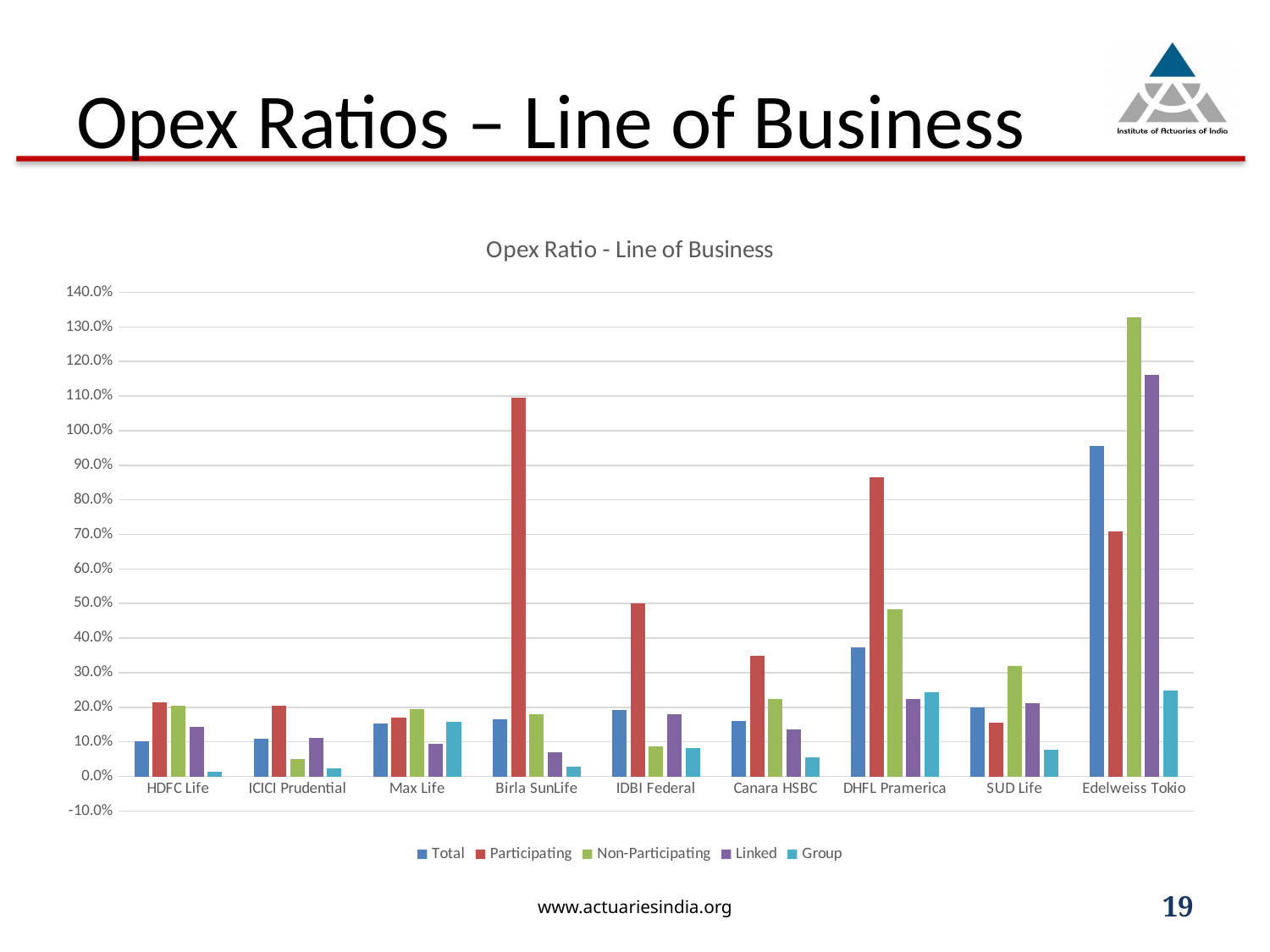
Which company has the highest Total opex ratio? Edelweiss Tokio How many companies are shown along the x axis of the chart? 9 Which company has the highest Non-Participating opex ratio? Edelweiss Tokio Is the Total value for DHFL Pramerica greater or less than 30.0%? greater What type of chart is shown on the slide? bar chart Is the Group value for HDFC Life greater or less than 10.0%? less Which company has the highest Participating opex ratio? Birla SunLife What is the title of the chart? Opex Ratio - Line of Business How many series does the chart legend list? 5 Is the Non-Participating value for Edelweiss Tokio greater or less than 120.0%? greater For DHFL Pramerica, which is larger: the Participating or the Non-Participating value? Participating